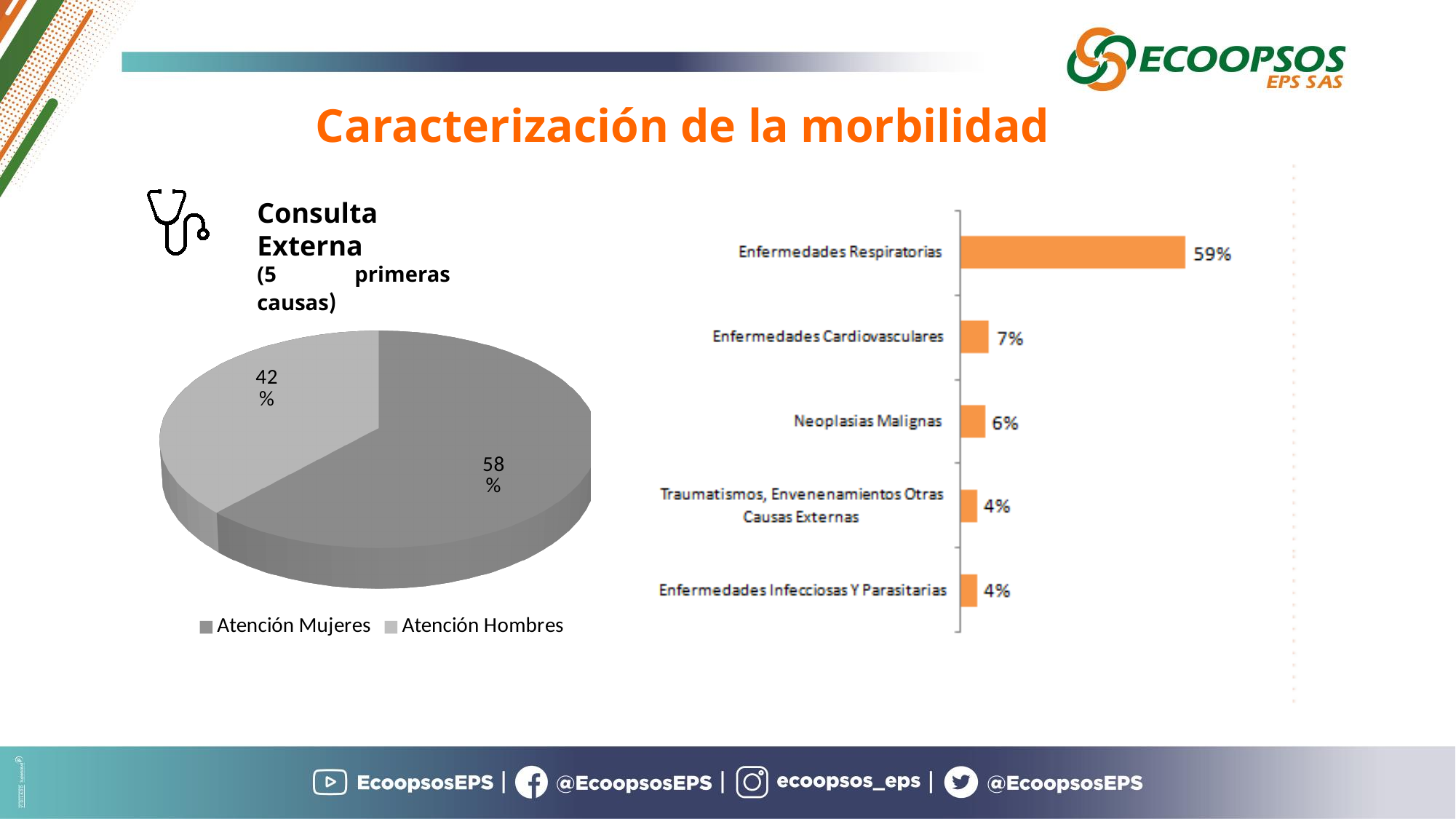
In the bar chart on the right, what is the value for Enfermedades Cardiovasculares? 7% In the pie chart on the left, what share is labelled for Atención Mujeres? 58% In the pie chart on the left, what share is labelled for Atención Hombres? 42% In the bar chart on the right, which category has the highest value? Enfermedades Respiratorias In the bar chart on the right, how many categories are shown? 5 In the pie chart on the left, which slice is larger, Atención Mujeres or Atención Hombres? Atención Mujeres What kind of chart is the chart on the left of the slide? Pie chart In the bar chart on the right, what is the difference between Enfermedades Respiratorias and Enfermedades Cardiovasculares? 52% In the pie chart on the left, how many entries does the legend list? 2 In the bar chart on the right, what is the value for Neoplasias Malignas? 6% In the bar chart on the right, what is the value for Enfermedades Respiratorias? 59% What kind of chart is the chart on the right of the slide? Bar chart